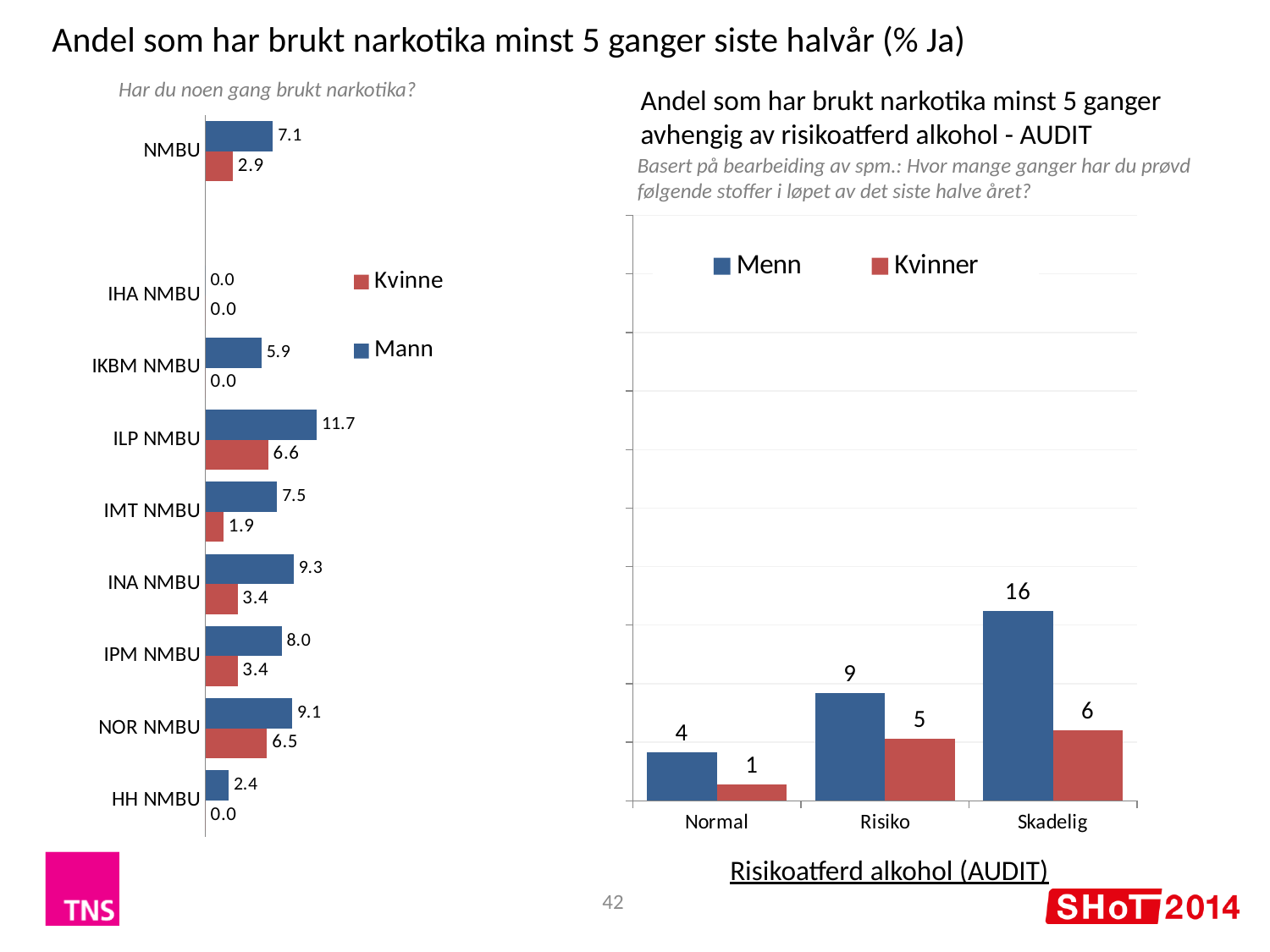
In the left chart, what is the value for Mann at ILP NMBU? 11.7 In the left chart, which is larger: the Mann value for INA NMBU or the Mann value for NOR NMBU? INA NMBU In the left chart, what is the value for Kvinne at NOR NMBU? 6.5 In the right chart (Risikoatferd alkohol AUDIT), what is the difference between Menn and Kvinner in the Risiko category? 4 In the right chart (Risikoatferd alkohol AUDIT), do the Menn values rise or fall from Normal to Skadelig? rise What kind of chart is the right chart (Risikoatferd alkohol AUDIT)? bar chart In the left chart, what is the difference between the Mann and Kvinne values for NMBU? 4.2 How many series does the legend of the right chart list? 2 In the right chart (Risikoatferd alkohol AUDIT), what is the value for Kvinner in the Normal category? 1 In the right chart (Risikoatferd alkohol AUDIT), what is the value for Menn in the Skadelig category? 16 In the left chart, which category has the highest Mann value? ILP NMBU How many categories are shown in the left chart? 9